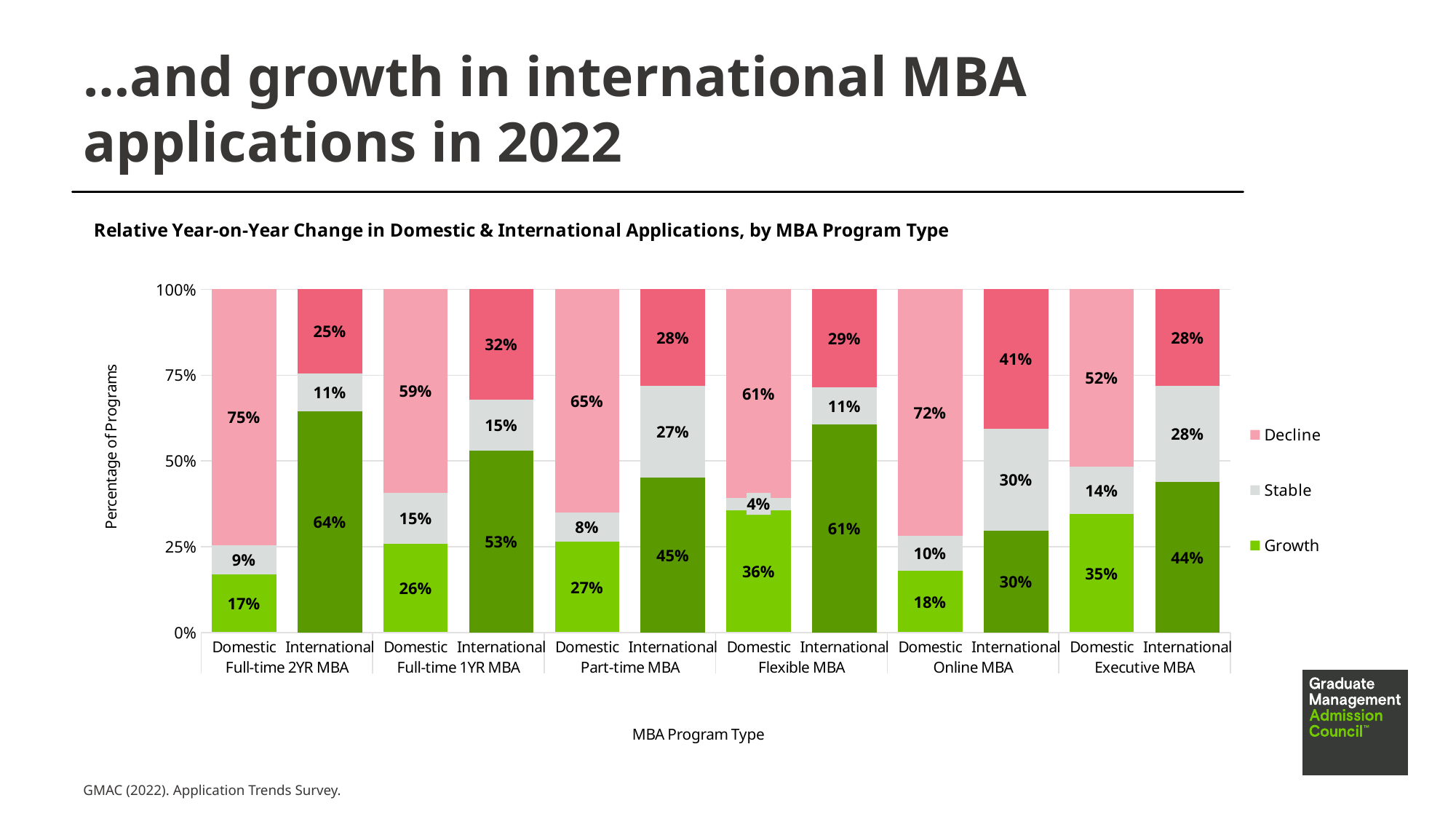
Which bar has the lowest Growth percentage? Domestic Full-time 2YR MBA Which is larger: the Decline value for Domestic Online MBA or the Decline value for Domestic Part-time MBA? Domestic Online MBA What is the title of the chart? Relative Year-on-Year Change in Domestic & International Applications, by MBA Program Type How many bars are plotted in the chart? 12 What is the difference between the Growth values for International and Domestic Flexible MBA programs? 25% Which bar has the highest Growth percentage? International Full-time 2YR MBA What type of chart is shown on the slide? Stacked bar chart What is the Stable value for International Online MBA programs? 30% What is the Growth value for International Full-time 2YR MBA programs? 64% How many series does the legend list? 3 What percentage of Domestic Full-time 2YR MBA programs reported a Decline in applications? 75% What is the Decline value for International Executive MBA programs? 28%